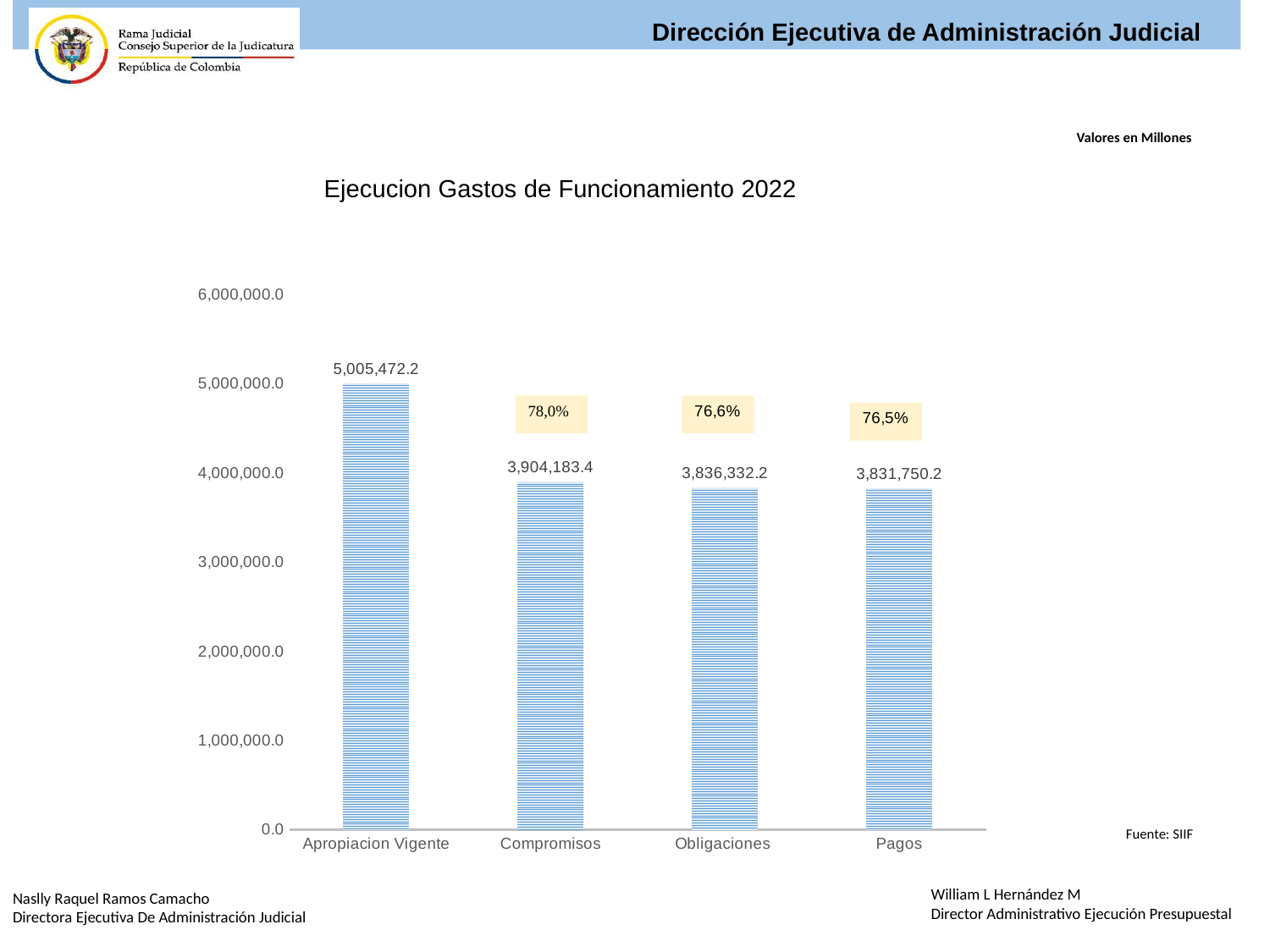
What kind of chart is this? bar chart What is the value for Apropiacion Vigente? 5,005,472.2 What percentage label is shown above the Compromisos bar? 78,0% What is the value for Compromisos? 3,904,183.4 Is the value for Apropiacion Vigente greater or less than 4,000,000.0? greater What is the value for Obligaciones? 3,836,332.2 What is the difference between Apropiacion Vigente and Compromisos? 1,101,288.8 Which category has the lowest value? Pagos How many categories are shown on the x axis? 4 Which is larger, Compromisos or Obligaciones? Compromisos What is the value for Pagos? 3,831,750.2 Which category has the highest value? Apropiacion Vigente